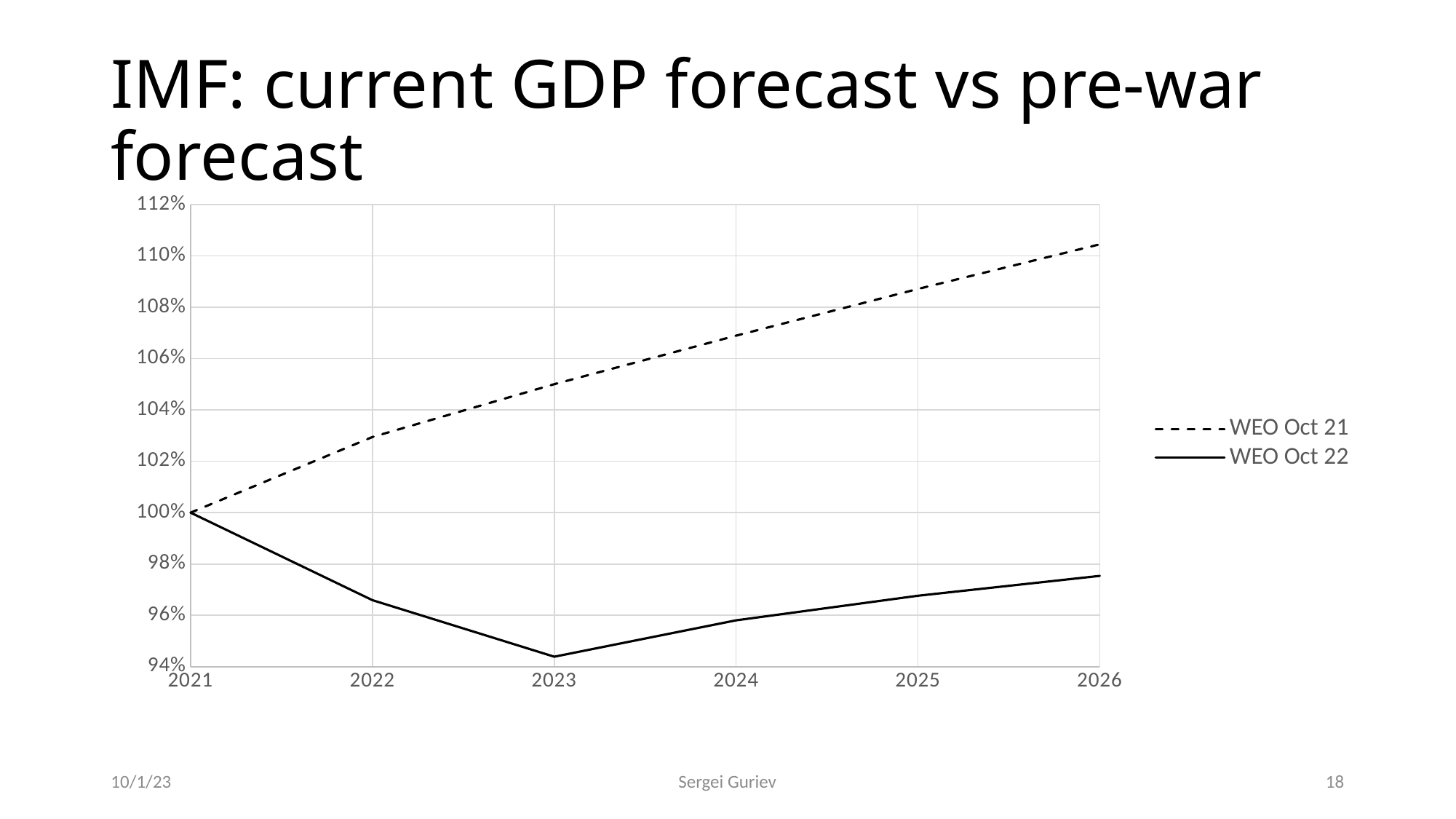
How many years are shown along the x axis? 6 Which series is drawn with a dashed line? WEO Oct 21 In which year is the WEO Oct 21 series at its highest? 2026 What is the value of WEO Oct 22 in 2021? 100% Does the WEO Oct 21 series rise or fall from 2021 to 2026? rise What is the value of WEO Oct 21 in 2021? 100% Which series is higher in 2024, WEO Oct 21 or WEO Oct 22? WEO Oct 21 Is the value for WEO Oct 22 in 2023 greater or less than 96%? less Is the value for WEO Oct 21 in 2024 greater or less than 106%? greater How many series does the legend list? 2 What kind of chart is shown on the slide? line chart In which year is the WEO Oct 22 series at its lowest? 2023